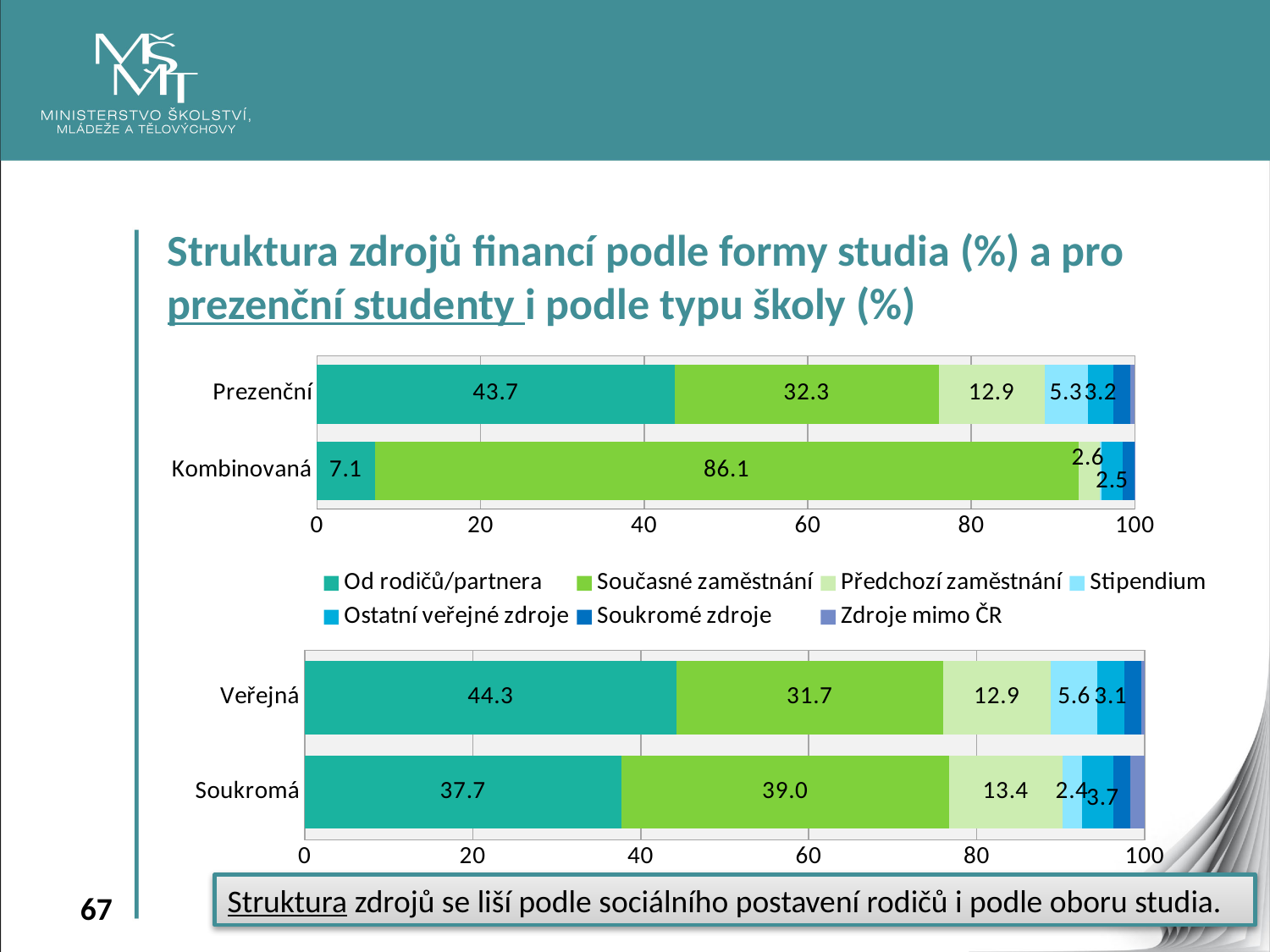
In the top chart, what is the value for Od rodičů/partnera for Kombinovaná? 7.1 In the bottom chart, how many categories are shown on the vertical axis? 2 What kind of chart is the bottom chart? stacked bar chart In the top chart, what is the value for Současné zaměstnání for Kombinovaná? 86.1 In the top chart, what is the value for Od rodičů/partnera for Prezenční? 43.7 In the top chart, is the Současné zaměstnání value for Kombinovaná greater or less than 80? greater In the top chart, what is the difference between the Od rodičů/partnera values for Prezenční and Kombinovaná? 36.6 In the bottom chart, what is the value for Současné zaměstnání for Veřejná? 31.7 In the bottom chart, which category has the larger value for Od rodičů/partnera, Veřejná or Soukromá? Veřejná In the bottom chart, what is the value for Předchozí zaměstnání for Soukromá? 13.4 In the bottom chart, what is the value for Stipendium for Veřejná? 5.6 How many series does the legend list? 7